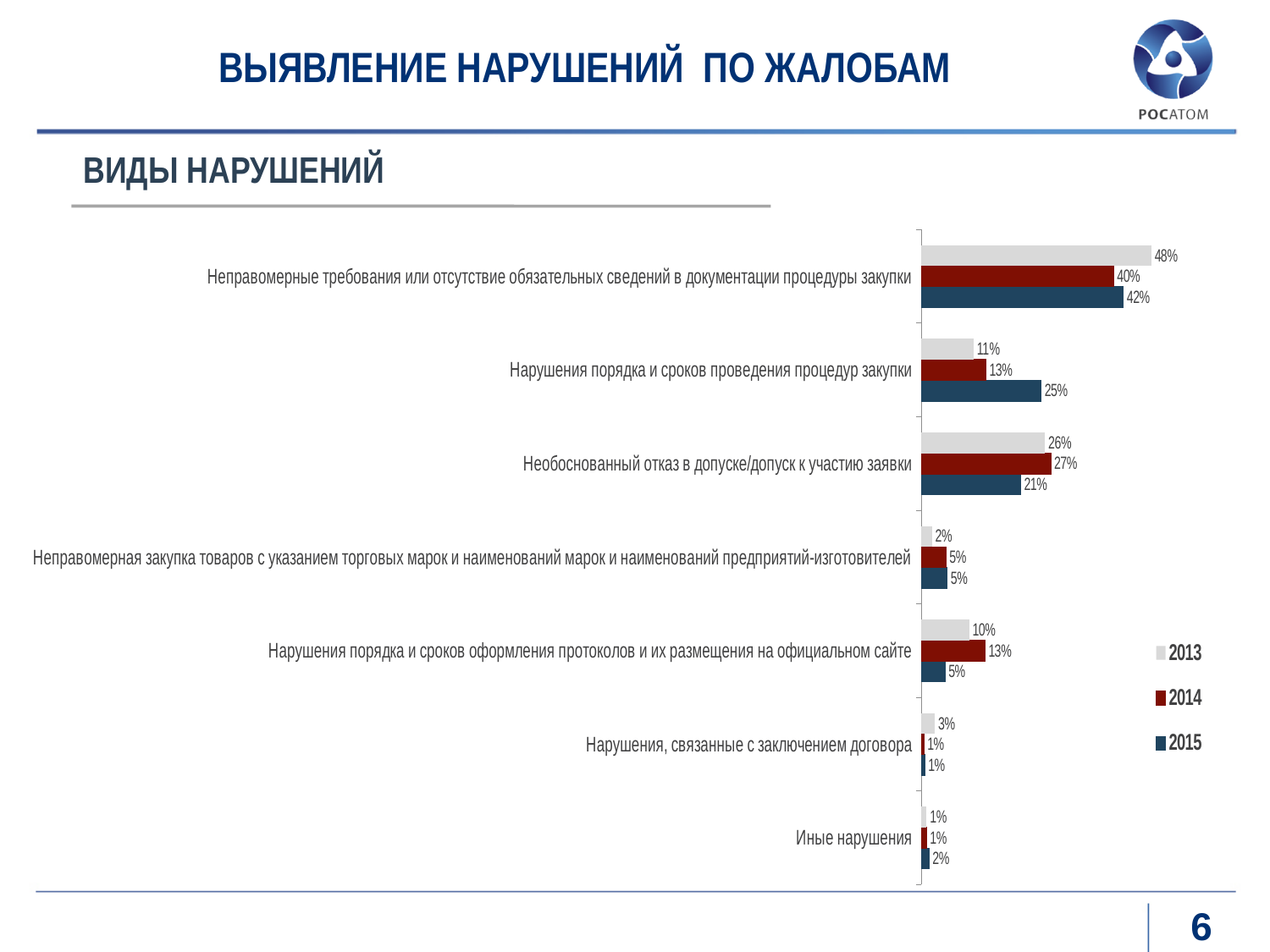
Which year does the dark blue series represent? 2015 How many series does the legend list? 3 Which category has the highest 2015 value? Неправомерные требования или отсутствие обязательных сведений в документации процедуры закупки What kind of chart is shown on the slide? Bar chart What is the 2015 value for "Нарушения порядка и сроков проведения процедур закупки"? 25% Which is larger for "Нарушения порядка и сроков оформления протоколов и их размещения на официальном сайте": the 2014 value or the 2015 value? 2014 What is the difference between the 2015 and 2013 values for "Нарушения порядка и сроков проведения процедур закупки"? 14% What is the 2014 value for "Необоснованный отказ в допуске/допуск к участию заявки"? 27% What is the 2013 value for "Неправомерные требования или отсутствие обязательных сведений в документации процедуры закупки"? 48% What is the difference between the 2013 and 2014 values for "Неправомерные требования или отсутствие обязательных сведений в документации процедуры закупки"? 8% How many categories are shown on the chart? 7 Which category has the lowest 2013 value? Иные нарушения